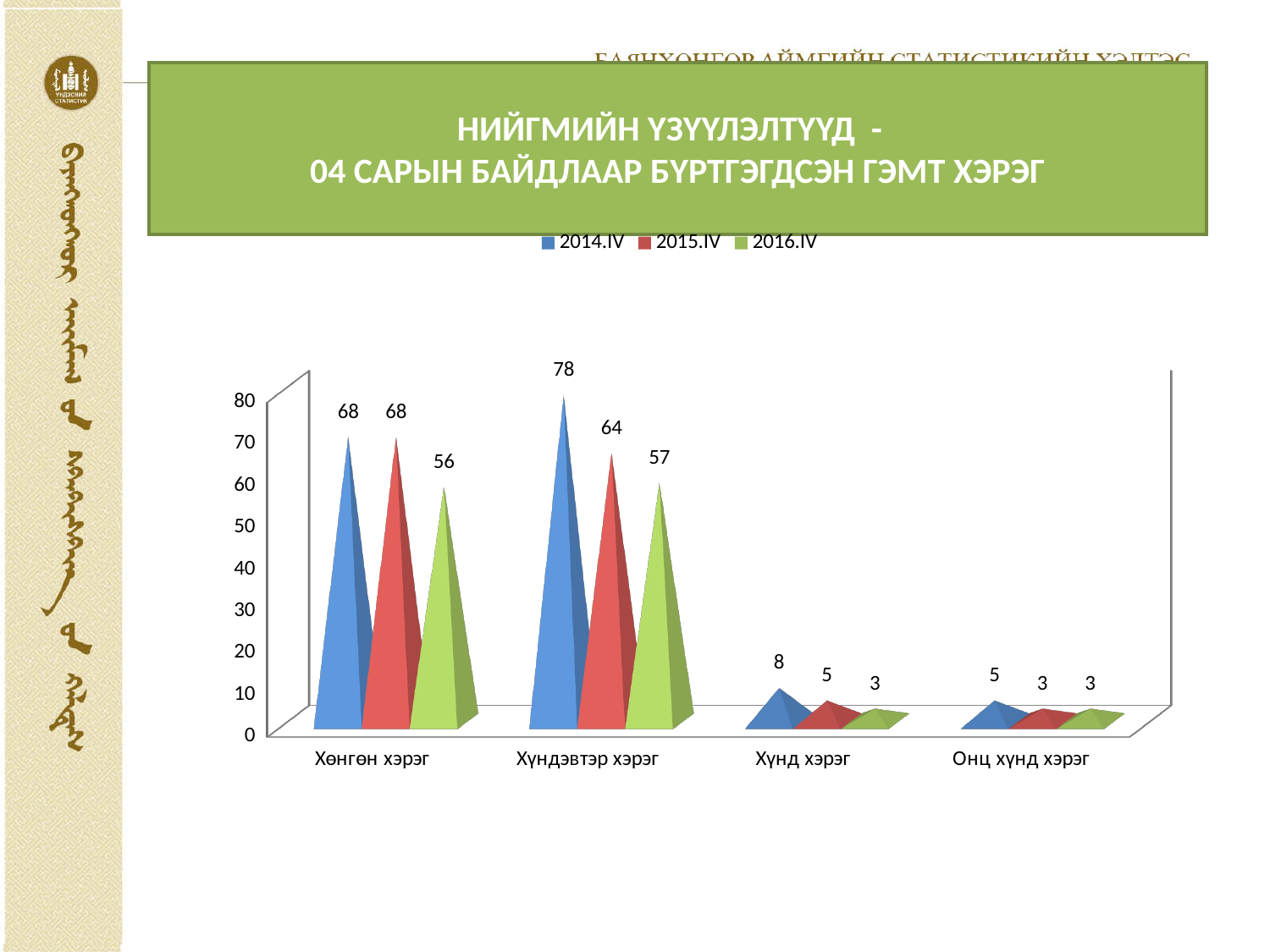
What is the difference between the 2014.IV and 2016.IV values for Хүндэвтэр хэрэг? 21 What kind of chart is shown on the slide? bar chart How many series does the legend list? 3 What is the value for Хүнд хэрэг in the 2015.IV series? 5 Which category has the lowest value in the 2016.IV series? Хүнд хэрэг and Онц хүнд хэрэг (both 3) Which category has the highest value in the 2014.IV series? Хүндэвтэр хэрэг What is the value for Хүндэвтэр хэрэг in the 2014.IV series? 78 What is the value for Хөнгөн хэрэг in the 2016.IV series? 56 Which is larger for Хөнгөн хэрэг: the 2015.IV value or the 2016.IV value? 2015.IV Which series is shown in green in the legend? 2016.IV How many categories are shown on the x axis? 4 What is the value for Онц хүнд хэрэг in the 2014.IV series? 5